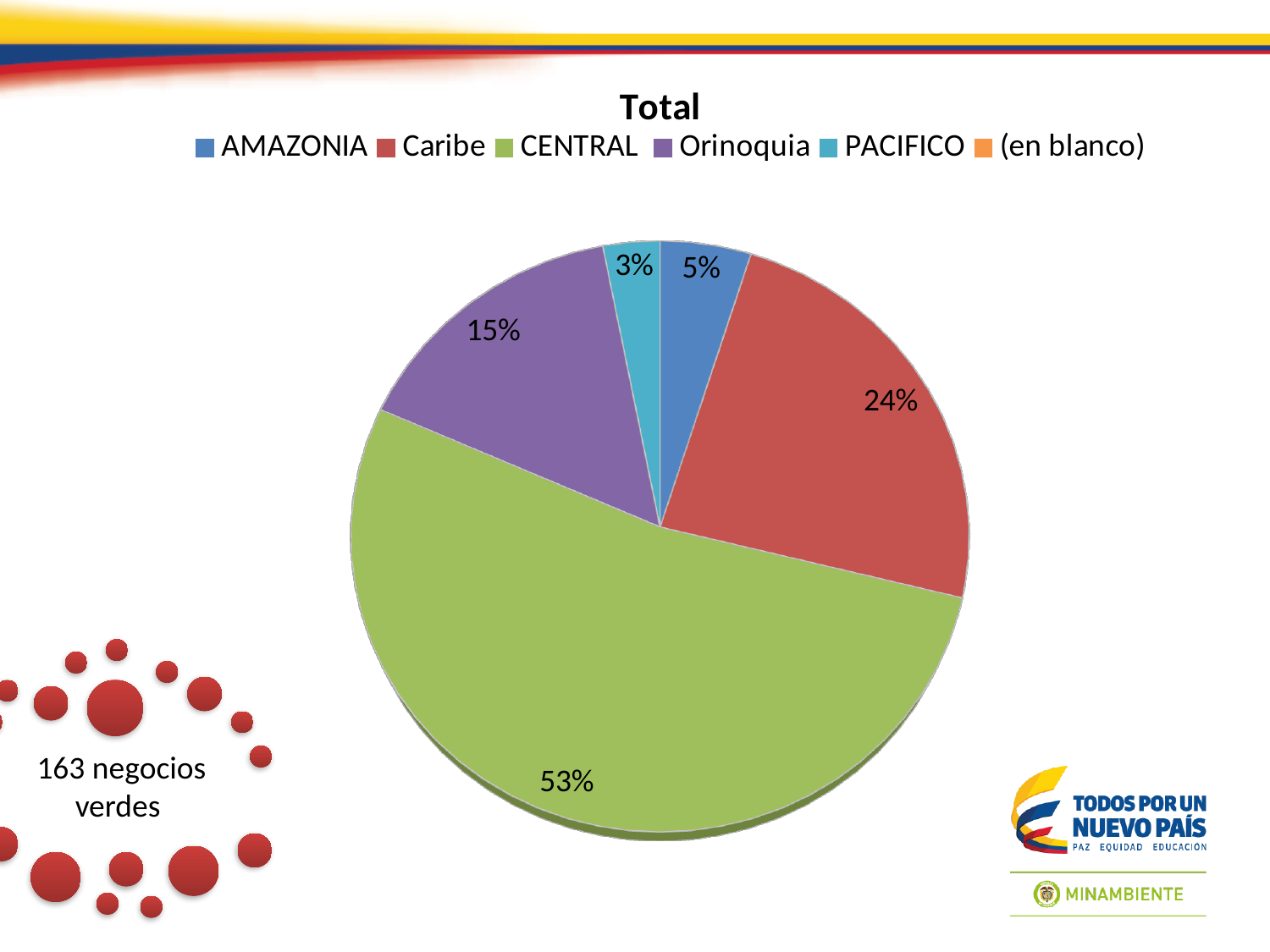
What share of the pie does AMAZONIA have? 5% What share of the pie does CENTRAL have? 53% What share of the pie does Caribe have? 24% Which region has the largest slice of the pie? CENTRAL What is the chart's title? Total How many entries does the legend list? 6 Which region has the smallest visible slice of the pie? PACIFICO Which slice is larger, Orinoquia or AMAZONIA? Orinoquia What kind of chart is shown on the slide? pie chart What is the difference in percentage points between the CENTRAL and Caribe slices? 29